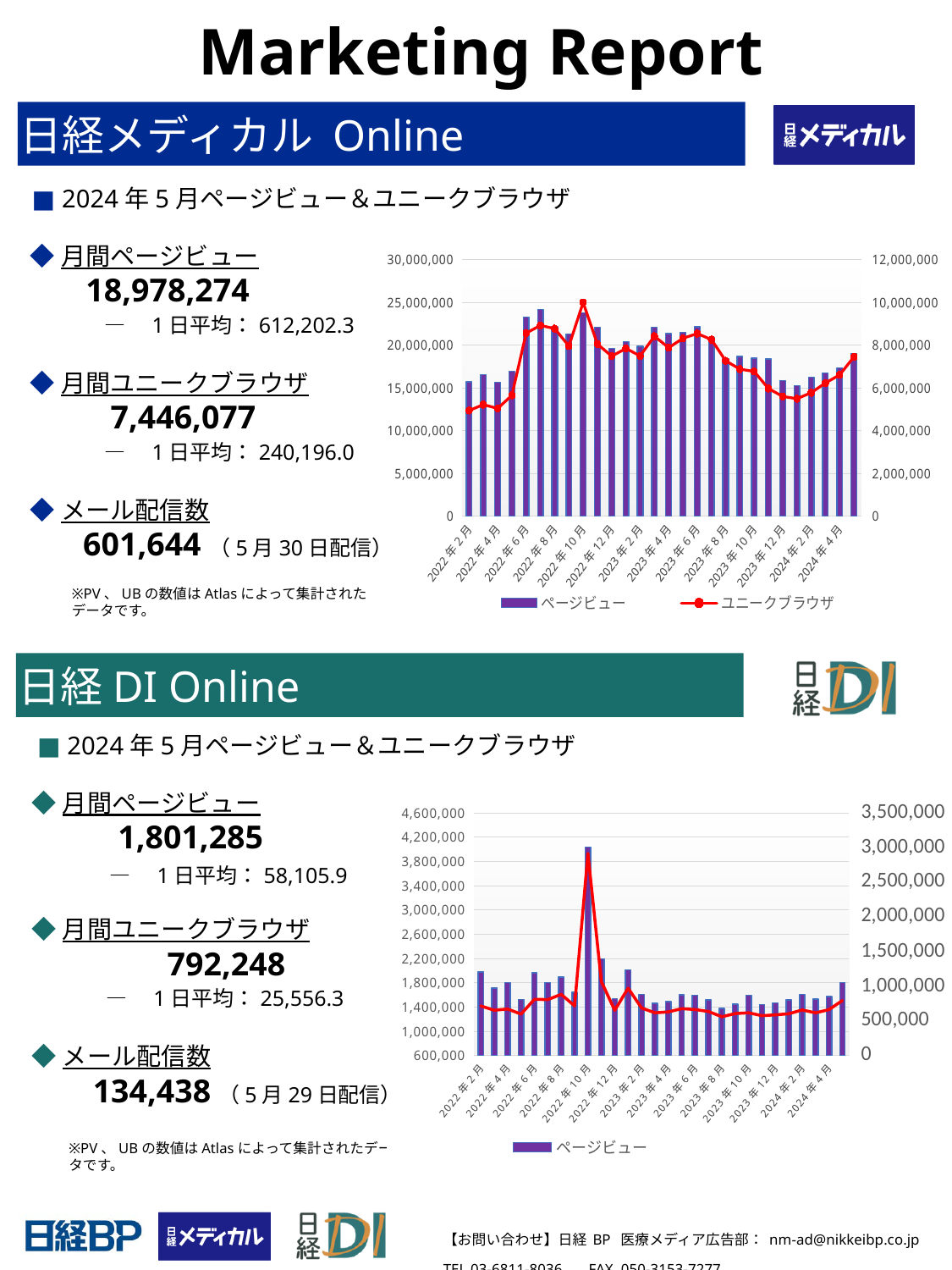
In the bottom chart (日経 DI Online), is the ページビュー value for 2022年10月 greater or less than 3,400,000? greater How many series does the legend of the top chart (日経メディカル Online) list? 2 In the top chart (日経メディカル Online), what colour is the ユニークブラウザ line? red In the bottom chart (日経 DI Online), is the ページビュー value for 2024年4月 greater or less than 2,200,000? less How many series does the legend of the bottom chart (日経 DI Online) list? 1 In the top chart (日経メディカル Online), do the ページビュー bars rise or fall from 2022年2月 to 2022年8月? rise In the top chart (日経メディカル Online), in which month does the ユニークブラウザ line reach its highest point? 2022年10月 In the top chart (日経メディカル Online), is the ページビュー value for 2022年8月 greater or less than 20,000,000? greater What kind of chart is the 日経メディカル Online chart (top chart)? combination bar and line chart In the top chart (日経メディカル Online), which month has the larger ページビュー bar, 2022年8月 or 2024年4月? 2022年8月 In the bottom chart (日経 DI Online), which month has the highest ページビュー bar? 2022年10月